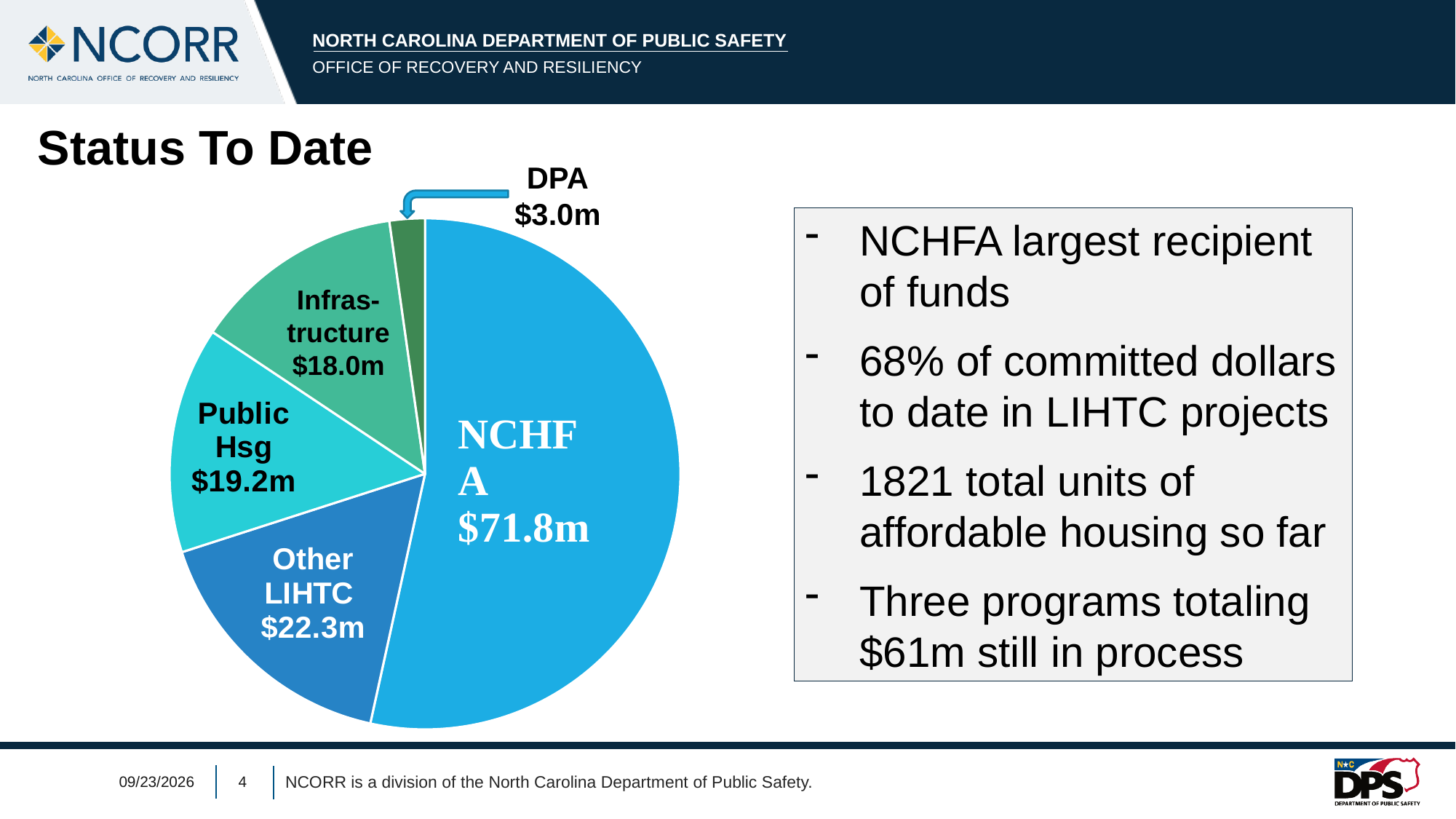
How many slices does the pie chart have? 5 What is the difference between the NCHFA value and the Other LIHTC value? $49.5m What kind of chart is shown on the slide? pie chart What is the value shown for NCHFA in the pie chart? $71.8m What is the difference between the Other LIHTC value and the Public Hsg value? $3.1m Which is larger, the Public Hsg value or the Infrastructure value? Public Hsg Which category has the largest slice in the pie chart? NCHFA What is the value shown for Infrastructure in the pie chart? $18.0m What is the total of all the values shown in the pie chart? $134.3m Which category has the smallest slice in the pie chart? DPA What is the value shown for Public Hsg in the pie chart? $19.2m What is the value shown for DPA in the pie chart? $3.0m